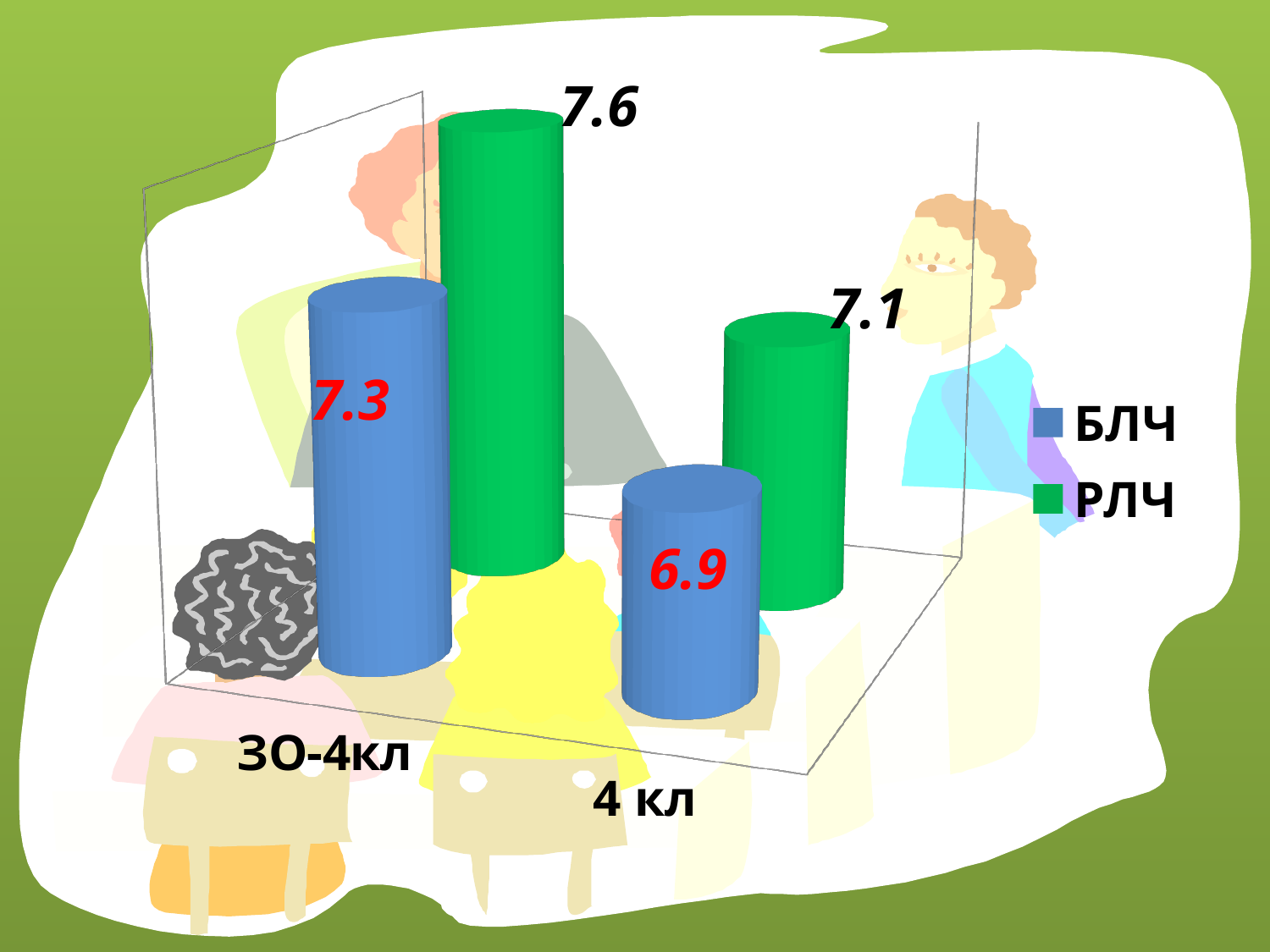
What is the difference between the БЛЧ values for ЗО-4кл and 4 кл? 0.4 How many series does the legend list? 2 What is the value of РЛЧ for ЗО-4кл? 7.6 Which bar has the highest value on the chart? РЛЧ for ЗО-4кл How many categories are shown on the x axis? 2 What is the value of РЛЧ for 4 кл? 7.1 What kind of chart is shown on the slide? Bar chart Which is larger for 4 кл: БЛЧ or РЛЧ? РЛЧ What is the value of БЛЧ for 4 кл? 6.9 What is the value of БЛЧ for ЗО-4кл? 7.3 What is the difference between the РЛЧ and БЛЧ values for ЗО-4кл? 0.3 Which bar has the lowest value on the chart? БЛЧ for 4 кл